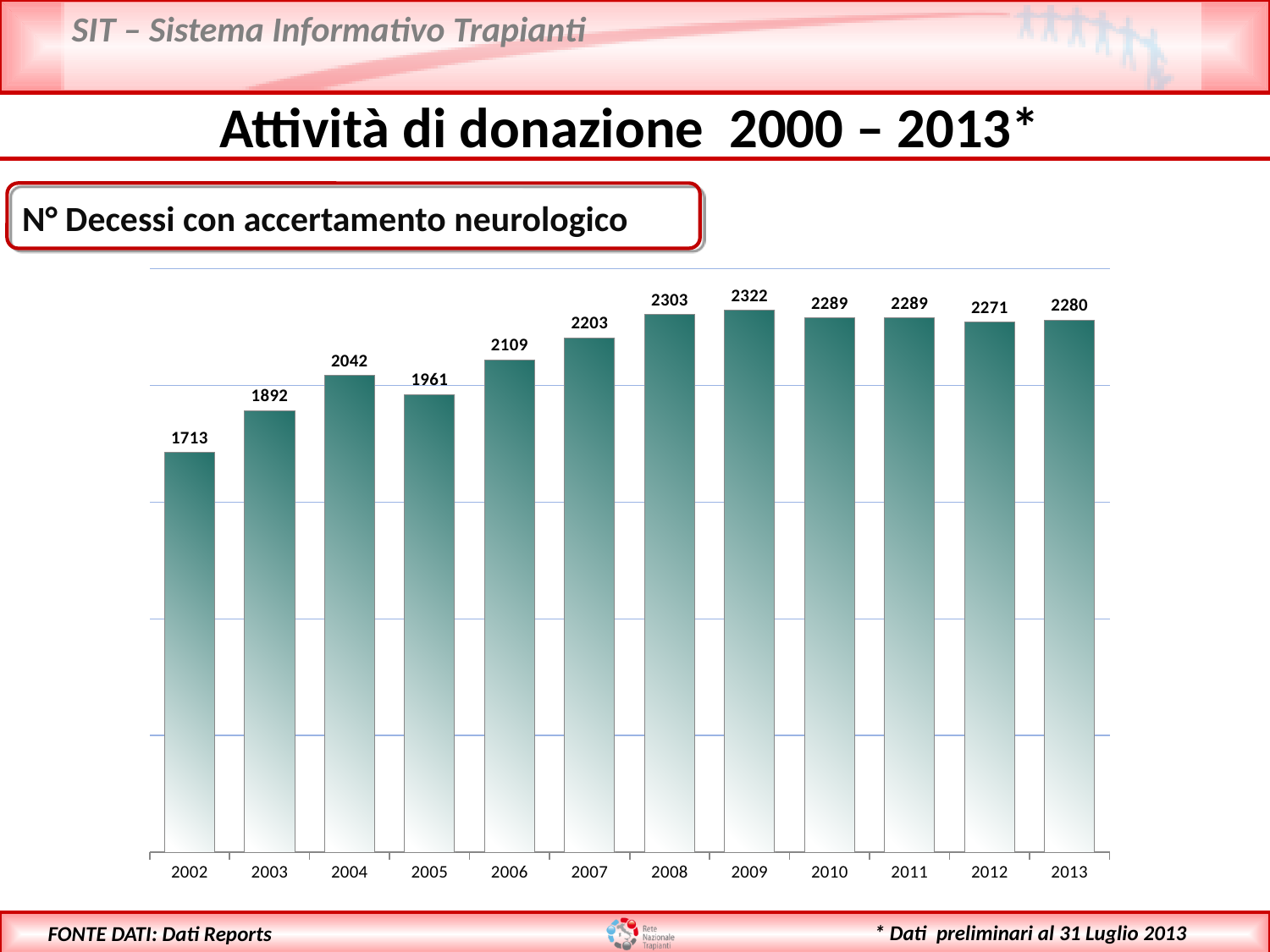
What is the title shown in the box above the chart? N° Decessi con accertamento neurologico What is the value for 2013? 2280 Which year has the highest value? 2009 What is the value for 2002? 1713 How many years are shown on the x axis? 12 What is the value for 2009? 2322 Do the values generally rise or fall from 2002 to 2009? rise What is the difference between the values for 2009 and 2002? 609 Which year has the lowest value? 2002 Which is larger, the value for 2005 or the value for 2006? 2006 What is the difference between the values for 2004 and 2005? 81 What kind of chart is this? bar chart